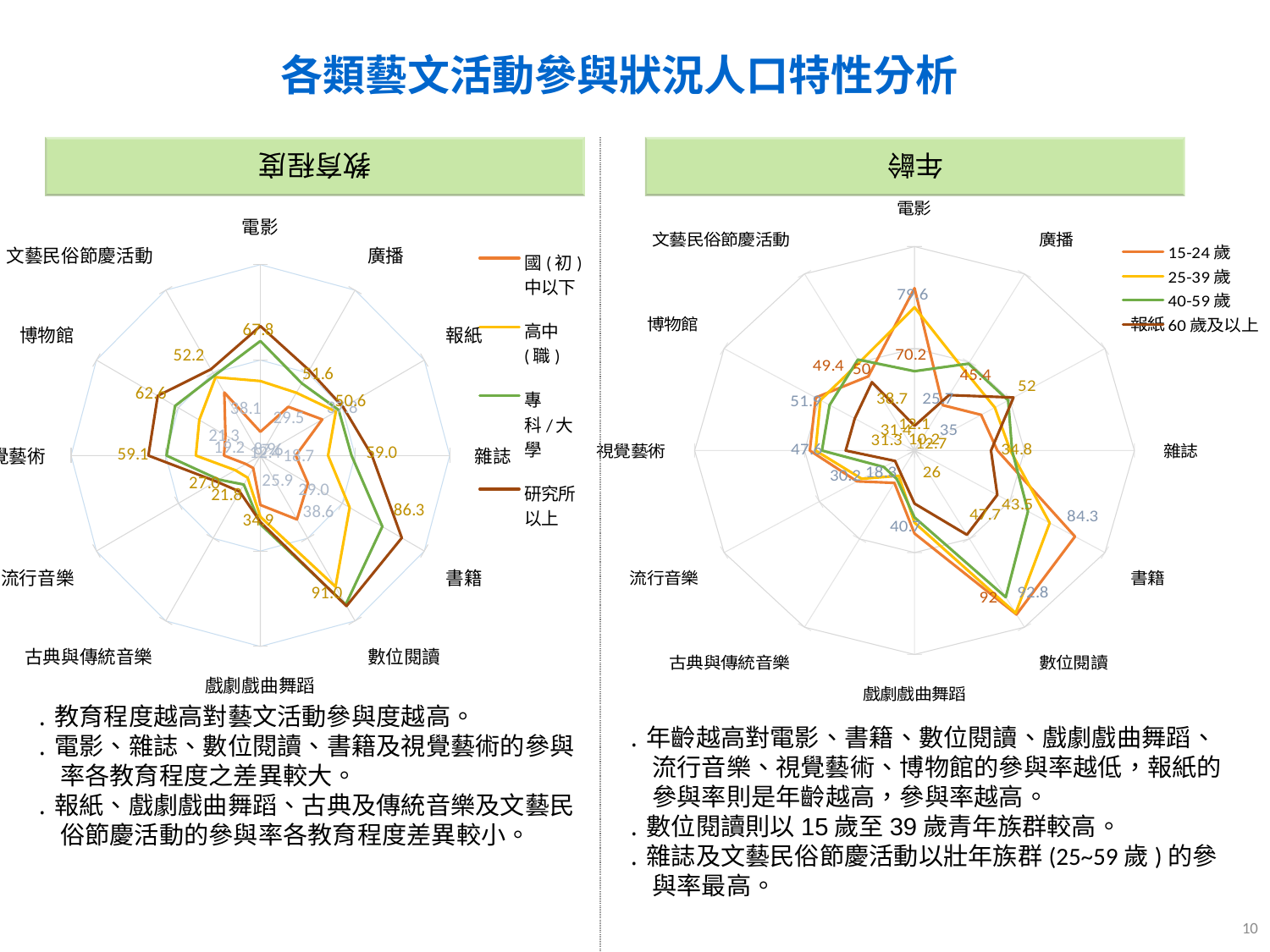
In the left chart (教育程度), for the 研究所以上 group, which is higher: 書籍 or 廣播? 書籍 What kind of chart is used on the left side of the slide (教育程度)? Radar chart In the right chart (年齡), which category has the highest value for the 15-24 歲 group? 數位閱讀 In the right chart (年齡), for the 15-24 歲 group, which is higher: 數位閱讀 or 雜誌? 數位閱讀 How many activity categories are plotted around the left chart (教育程度)? 12 What kind of chart is used on the right side of the slide (年齡)? Radar chart In the right chart (年齡), which age group does the orange line represent? 15-24 歲 How many series does the legend of the right chart (年齡) list? 4 How many activity categories are plotted around the right chart (年齡)? 12 In the left chart (教育程度), which education level does the dark brown line represent? 研究所以上 In the right chart (年齡), for the 60 歲及以上 group, which is higher: 電影 or 數位閱讀? 數位閱讀 How many series does the legend of the left chart (教育程度) list? 4